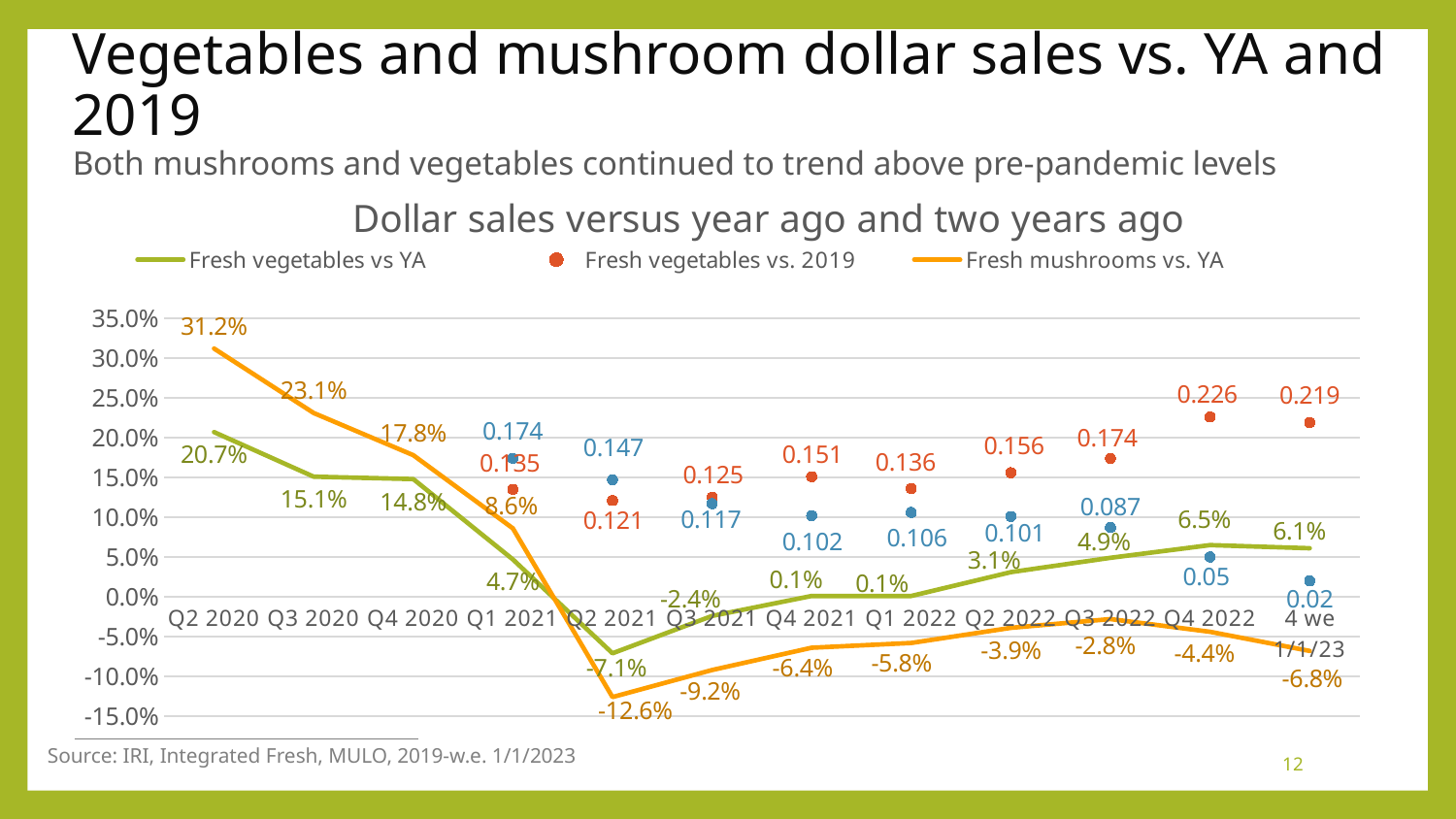
In Q2 2020, which is larger: Fresh vegetables vs YA or Fresh mushrooms vs. YA? Fresh mushrooms vs. YA What is the value for Fresh vegetables vs. 2019 in Q4 2022? 0.226 What is the difference between the Fresh mushrooms vs. YA values for Q2 2020 and Q3 2020? 8.1 percentage points What is the value for Fresh mushrooms vs. YA in Q2 2020? 31.2% Does Fresh mushrooms vs. YA rise or fall from Q2 2020 to Q2 2021? Fall In which period is Fresh vegetables vs. 2019 at its highest? Q4 2022 In which period is Fresh mushrooms vs. YA at its lowest? Q2 2021 How many series does the chart legend list? 3 What kind of chart is shown on the slide? Line chart What is the value for Fresh vegetables vs YA in Q2 2020? 20.7% What is the value for Fresh vegetables vs YA in Q2 2021? -7.1% How many time periods are shown along the x axis? 12